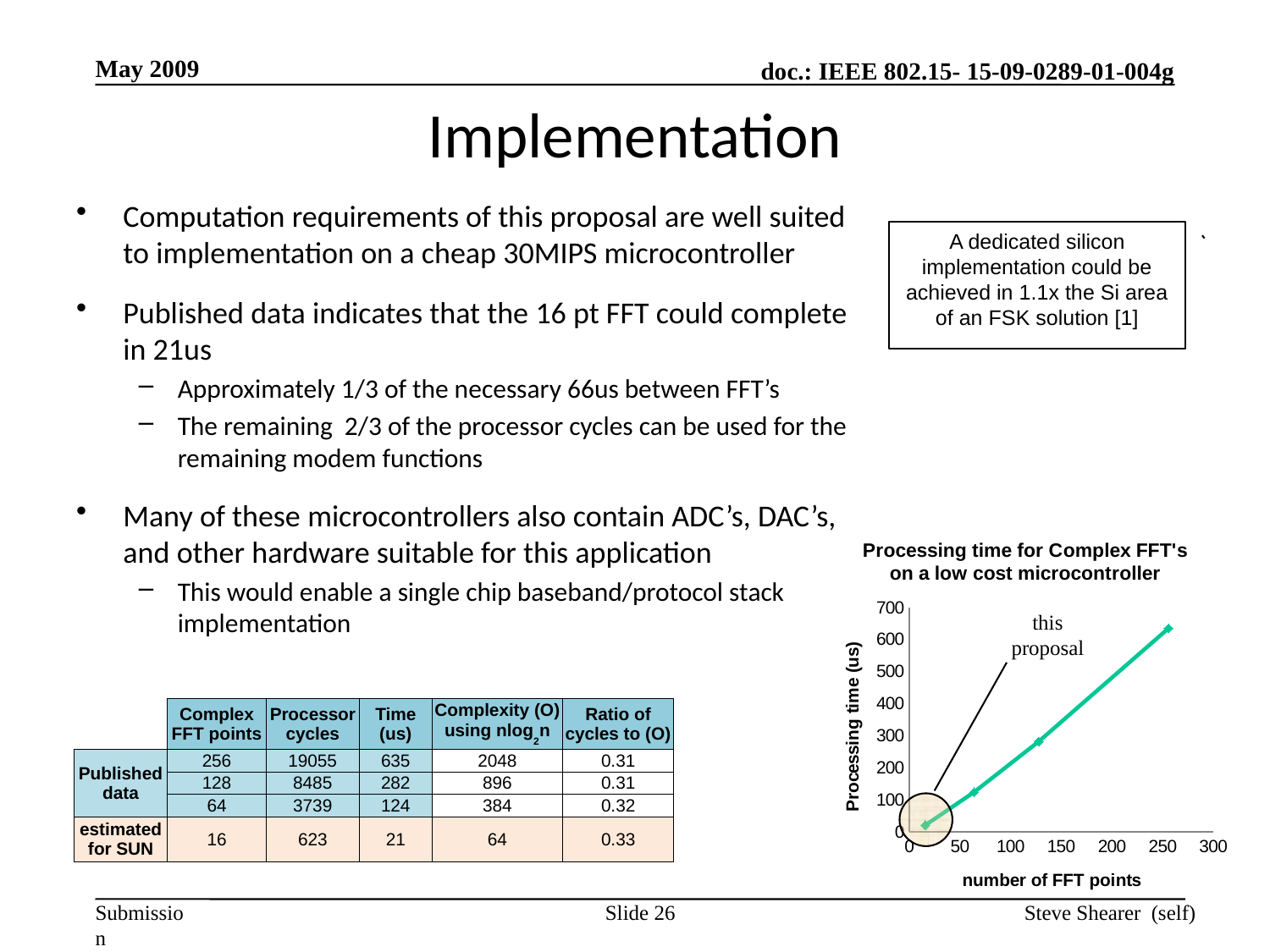
At which number of FFT points is the processing time lowest? 16 Is the processing time for 128 FFT points greater or less than 200 us? greater What kind of chart is shown on the slide? line chart What is the title of the chart on the slide? Processing time for Complex FFT's on a low cost microcontroller Is the processing time for 256 FFT points greater or less than 500 us? greater Is the processing time for 64 FFT points greater or less than 200 us? less Which has the larger processing time on the chart, 128 FFT points or 64 FFT points? 128 FFT points Does the processing time rise or fall as the number of FFT points increases? rises At which number of FFT points is the processing time highest? 256 What is the label of the x axis of the chart? number of FFT points How many data points are plotted on the chart? 4